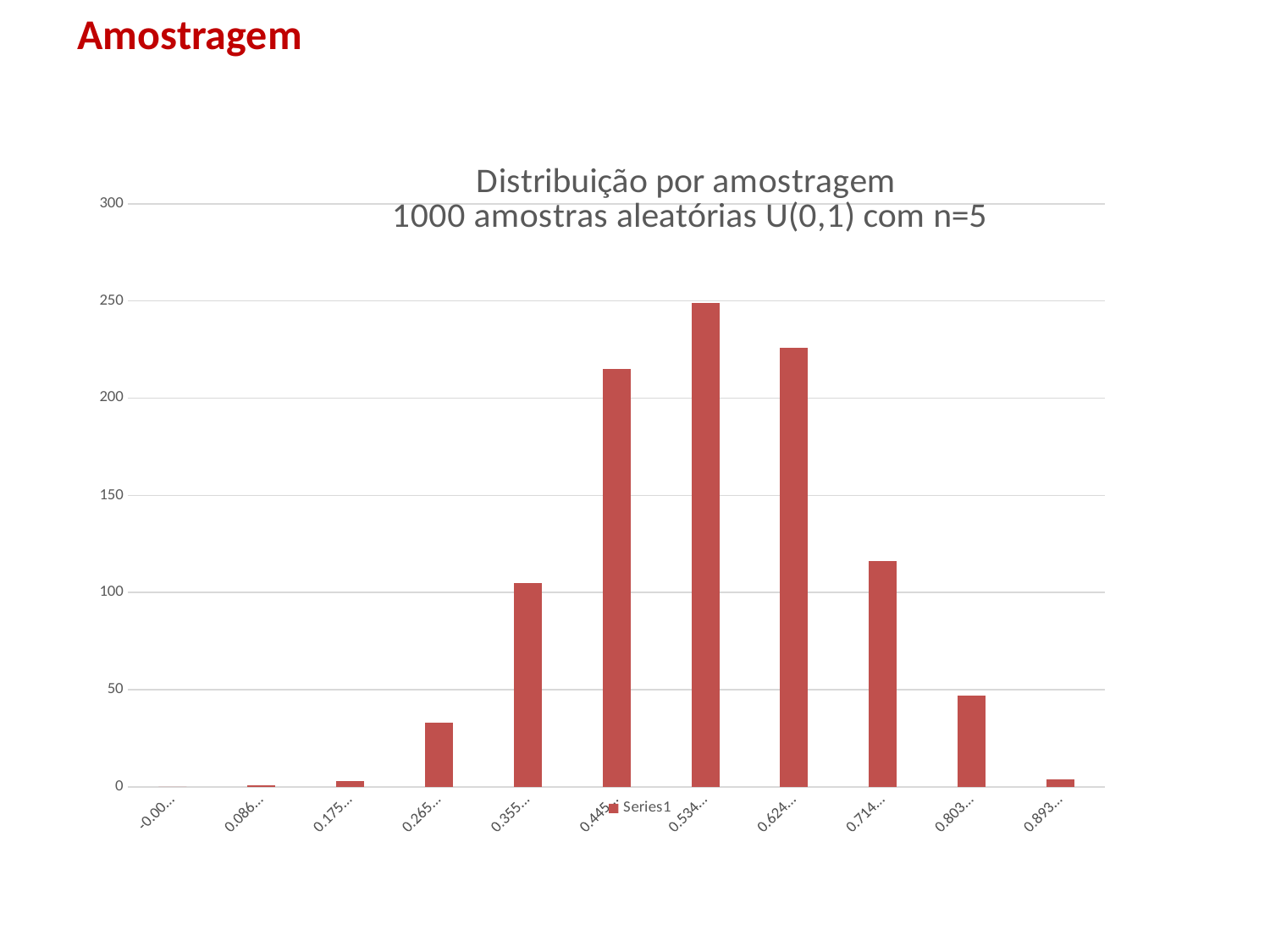
Is the value for the category 0.714... greater or less than 100? greater How many categories are shown on the x axis? 11 What is the title of the chart? Distribuição por amostragem 1000 amostras aleatórias U(0,1) com n=5 Which category has the highest bar? 0.534... What kind of chart is shown on the slide? bar chart Is the value for the category 0.355... greater or less than 150? less How many series does the legend list? 1 Which is larger, the value for 0.445... or the value for 0.714...? 0.445... Do the values rise or fall from the category 0.534... to the category 0.893...? fall Is the value for the category 0.265... greater or less than 50? less What is the name of the series shown in the legend? Series1